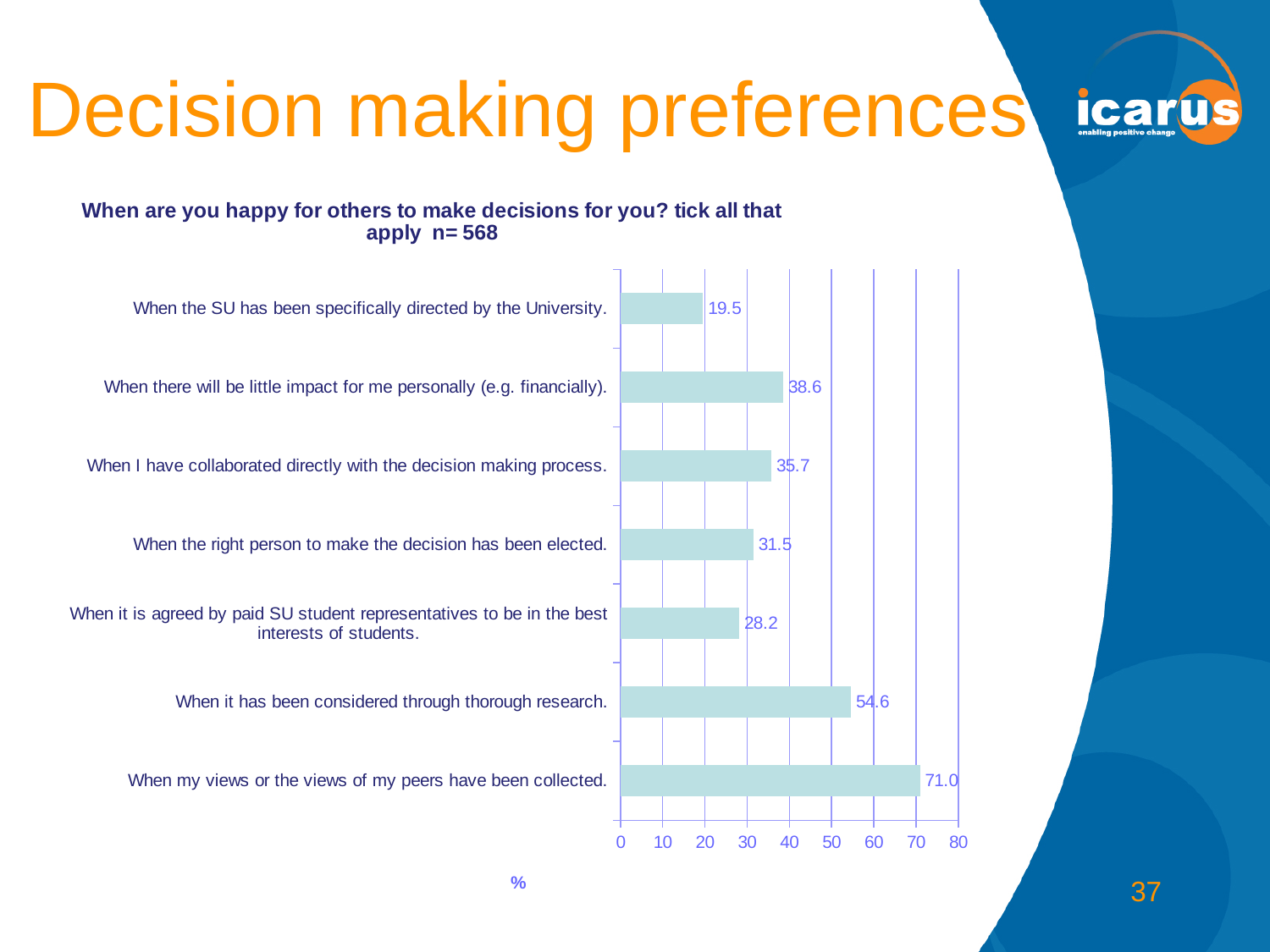
What is the value for "When it has been considered through thorough research."? 54.6 What is the sample size (n) stated in the chart title? 568 Which category has the highest value? When my views or the views of my peers have been collected. What is the value for "When the SU has been specifically directed by the University."? 19.5 What is the value for "When my views or the views of my peers have been collected."? 71.0 What is the difference between the values for "When there will be little impact for me personally (e.g. financially)." and "When I have collaborated directly with the decision making process."? 2.9 What is the value for "When the right person to make the decision has been elected."? 31.5 How many categories are shown in the chart? 7 Which is larger: the value for "When it has been considered through thorough research." or the value for "When it is agreed by paid SU student representatives to be in the best interests of students."? When it has been considered through thorough research. What kind of chart is shown on the slide? bar chart Which category has the lowest value? When the SU has been specifically directed by the University. Is the value for "When there will be little impact for me personally (e.g. financially)." greater or less than 30? greater